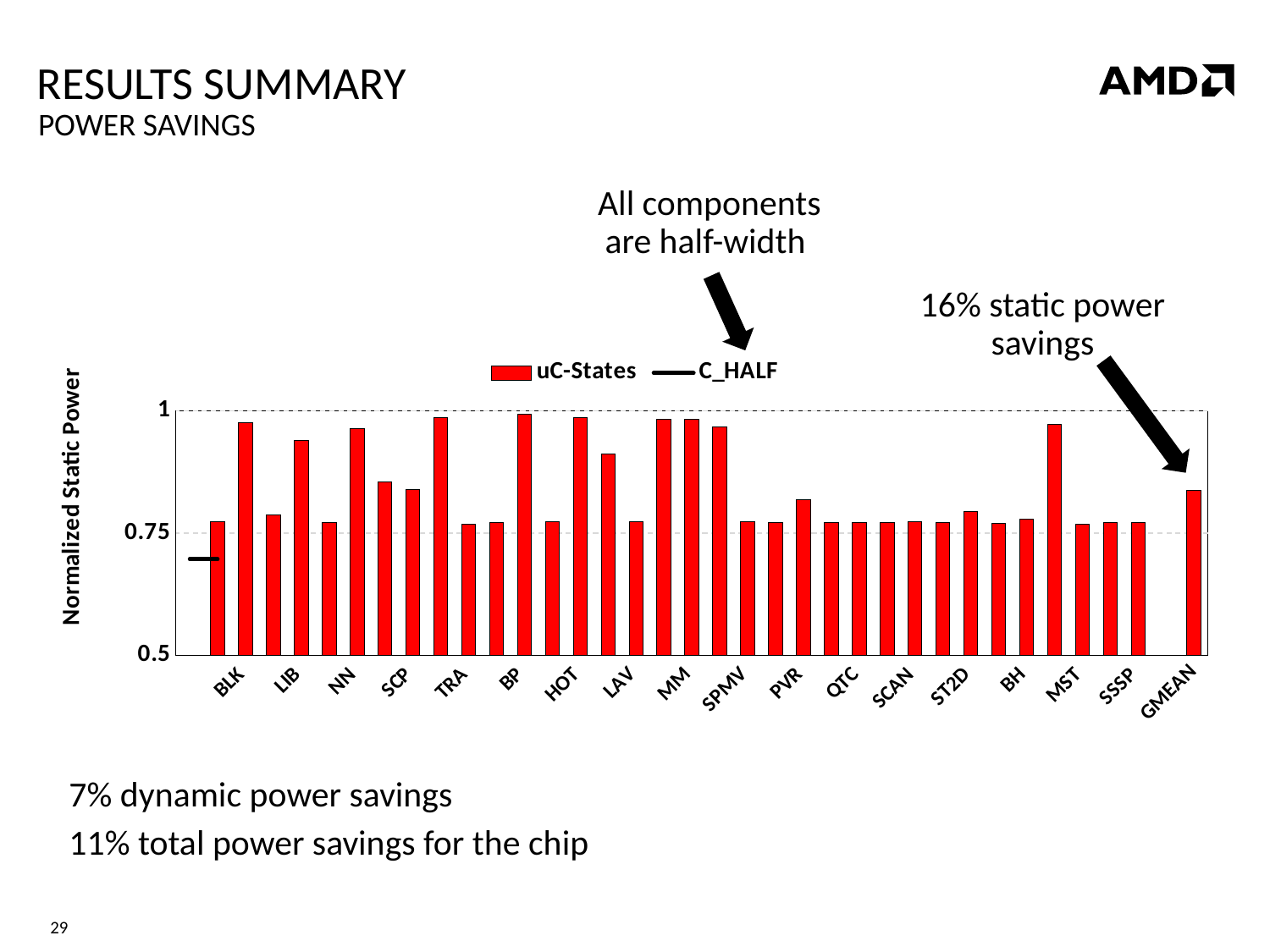
How many category labels are shown along the x axis? 18 What are the two entries in the chart legend? uC-States and C_HALF What is the label of the y axis? Normalized Static Power What is the first category label on the x axis? BLK What is the last category label on the x axis? GMEAN How many series does the chart legend list? 2 What is the lowest tick value shown on the y axis? 0.5 Is the value of the GMEAN bar greater or less than 0.75? greater What kind of chart is shown on the slide? bar chart Is the value of the GMEAN bar greater or less than 1? less What is the highest tick value shown on the y axis? 1